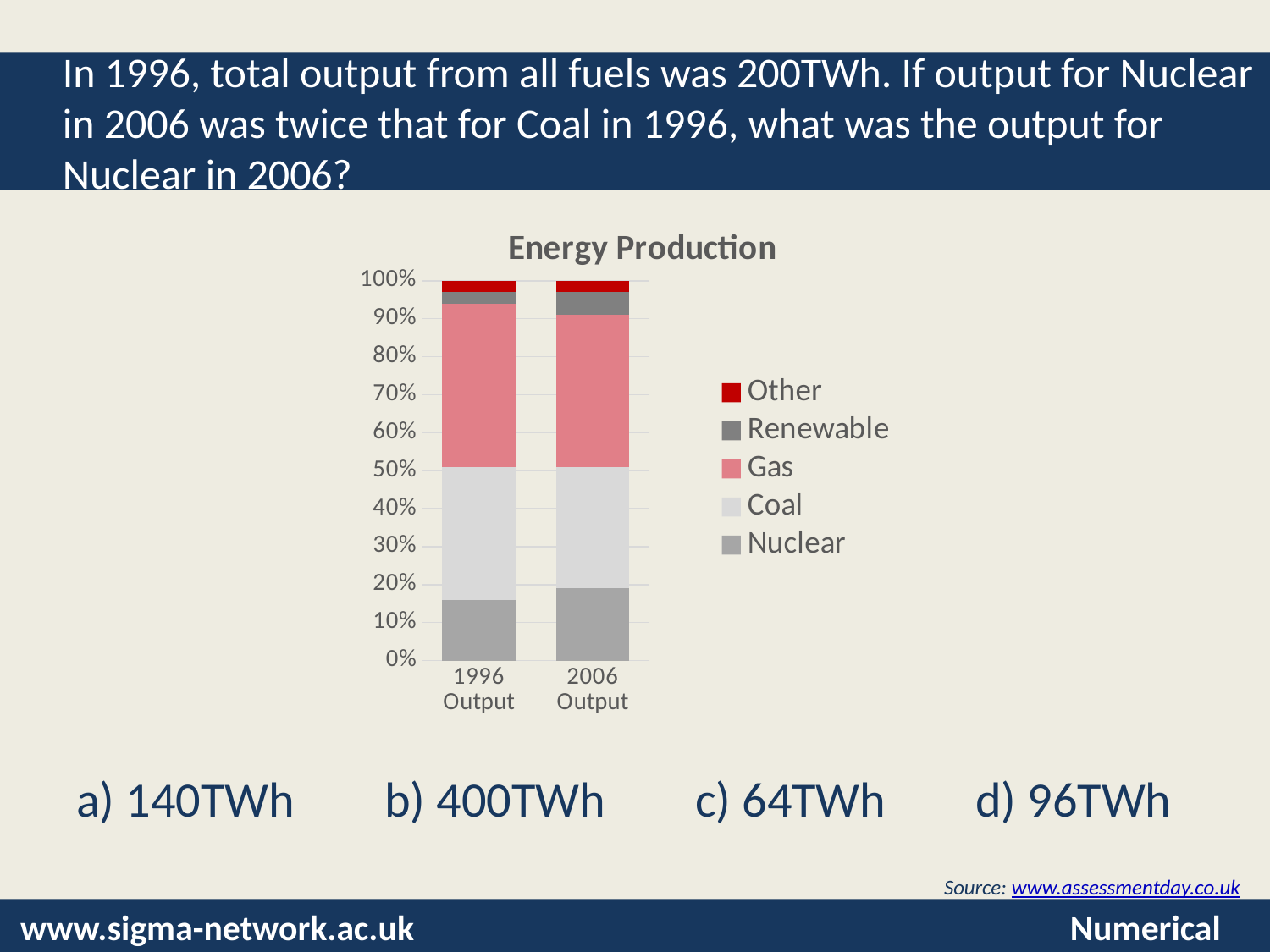
Which fuel has the largest share of the 2006 Output bar? Gas Is the Renewable share larger in 1996 Output or 2006 Output? 2006 Output What kind of chart is shown on the slide? Stacked bar chart How many series does the chart legend list? 5 Which series is shown in bright red in the legend? Other Is the Nuclear share of 1996 Output greater or less than 20%? less Which fuel has the largest share of the 1996 Output bar? Gas Is the Coal share of 1996 Output greater or less than 30%? greater What is the title of the chart? Energy Production How many bars (categories) are plotted in the chart? 2 Which fuel has the smallest share of the 2006 Output bar? Other Is the Gas share of 2006 Output greater or less than 30%? greater